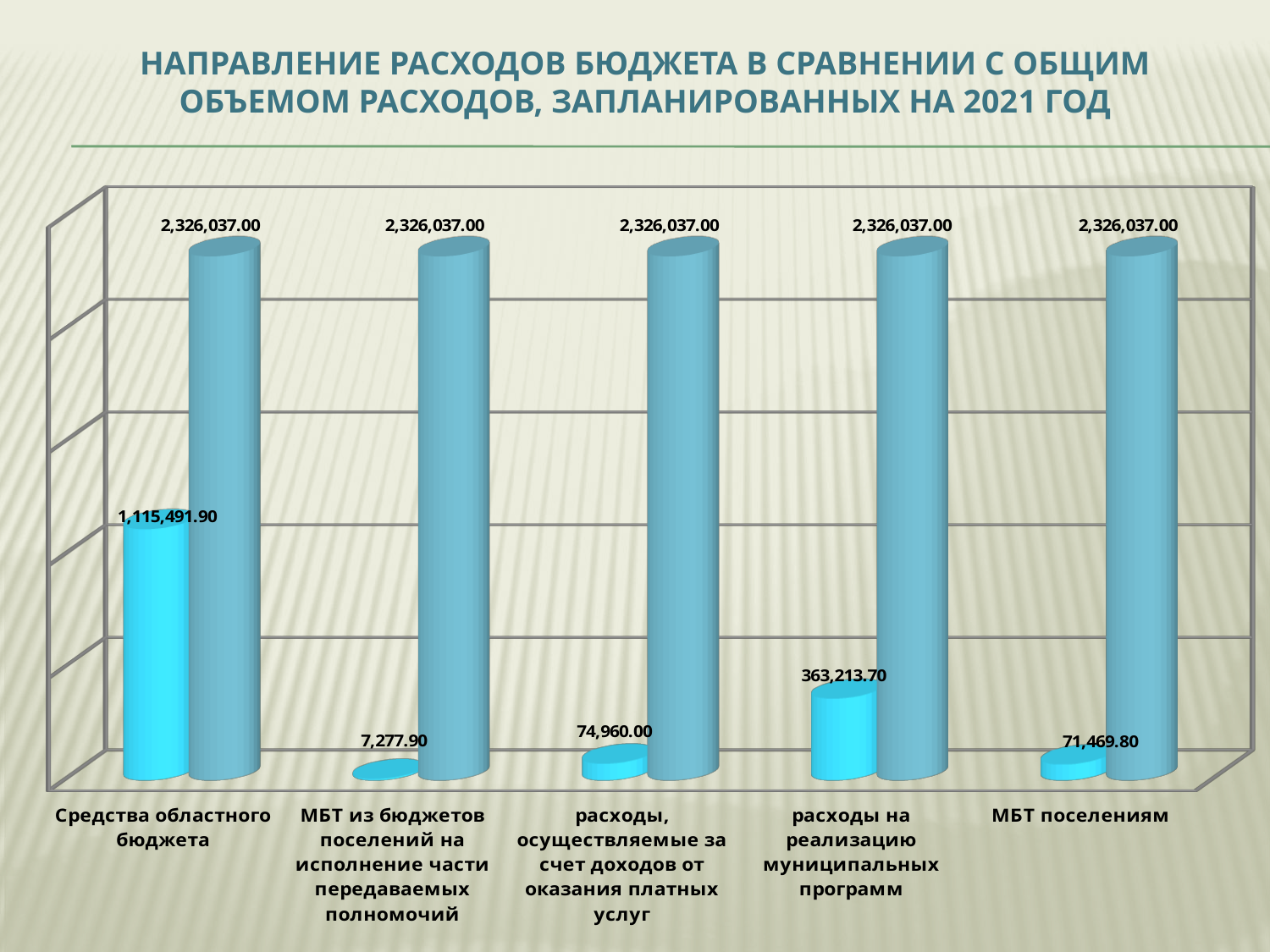
How many categories are shown on the x axis of the chart? 5 What is the difference between the dark blue bar (2,326,037.00) and the light blue bar for Средства областного бюджета? 1,210,545.10 What is the value of the light blue bar for расходы на реализацию муниципальных программ? 363,213.70 Which category has the lowest light blue bar? МБТ из бюджетов поселений на исполнение части передаваемых полномочий What value is shown on each of the tall dark blue bars? 2,326,037.00 What is the value of the light blue bar for МБТ из бюджетов поселений на исполнение части передаваемых полномочий? 7,277.90 What is the difference between the light blue values for расходы на реализацию муниципальных программ and расходы, осуществляемые за счет доходов от оказания платных услуг? 288,253.70 What is the value of the light blue bar for Средства областного бюджета? 1,115,491.90 Which light blue bar is larger: расходы, осуществляемые за счет доходов от оказания платных услуг or расходы на реализацию муниципальных программ? расходы на реализацию муниципальных программ What is the value of the light blue bar for МБТ поселениям? 71,469.80 Which category has the highest light blue bar? Средства областного бюджета What kind of chart is shown on the slide? Bar chart